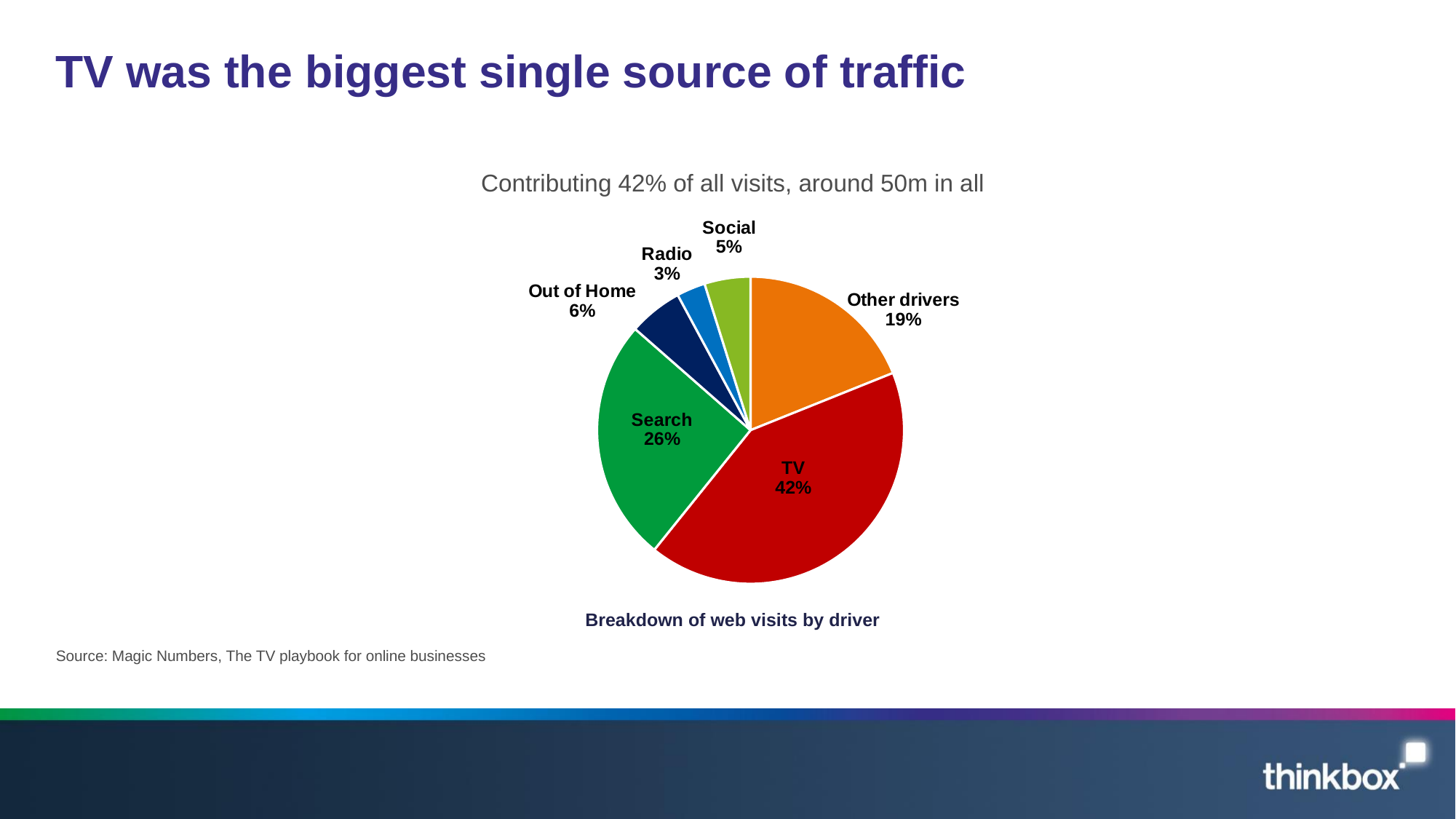
What is the title of the chart? Breakdown of web visits by driver Which driver has the largest share of web visits? TV What share of web visits do Other drivers account for? 19% Which driver has the smallest share of web visits? Radio What is the difference in percentage points between TV and Search? 16 Which has a larger share of web visits, Out of Home or Social? Out of Home What share of web visits does Search account for? 26% What share of web visits does Radio account for? 3% How many drivers are shown in the pie chart? 6 What share of web visits does TV account for? 42% What kind of chart is shown on the slide? Pie chart What colour is the TV slice of the pie chart? Red